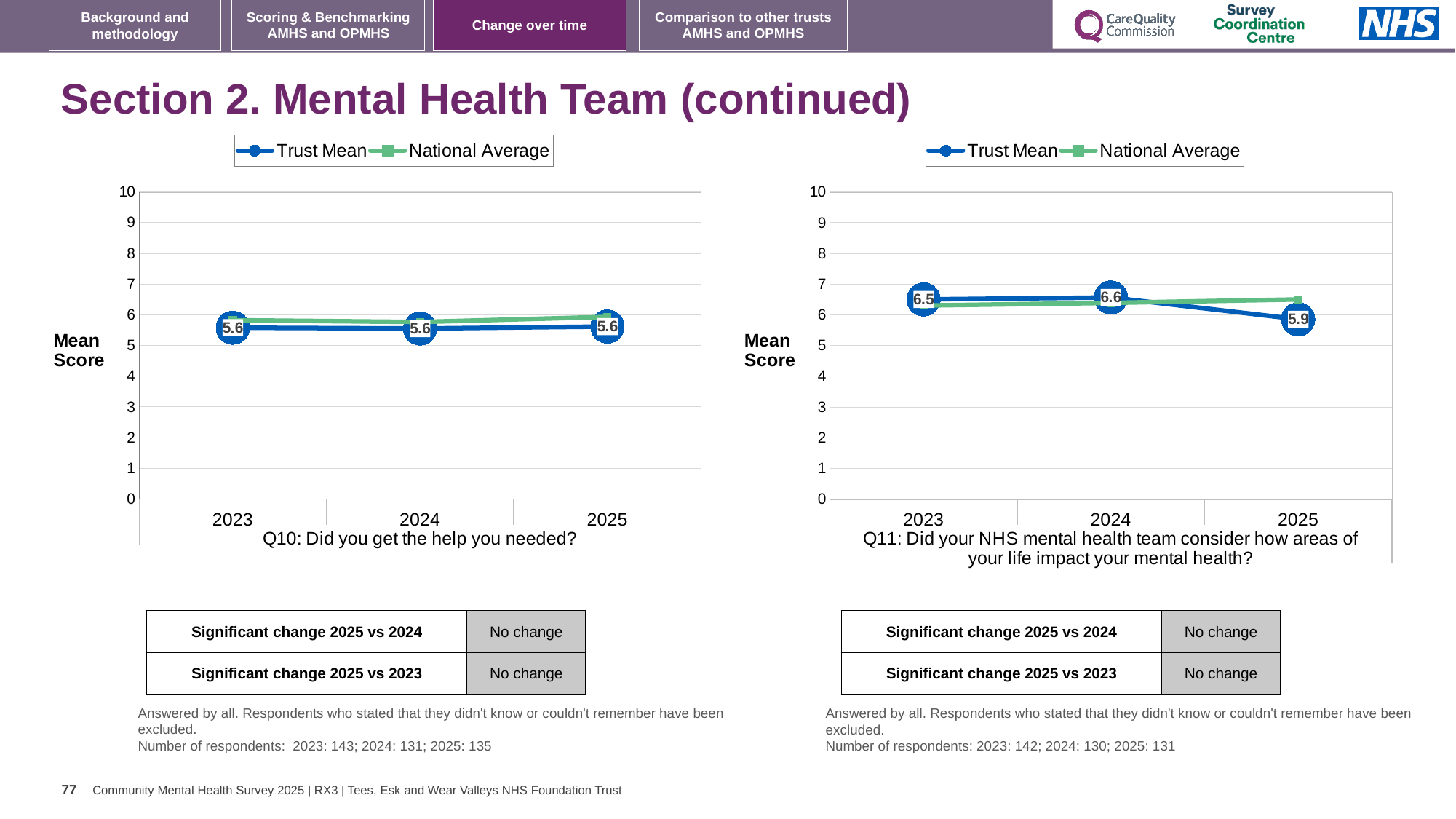
How many years are plotted on the x axis of the Q11 chart? 3 How many series does the legend of the Q10 chart list? 2 In the Q11 chart, which year has the highest Trust Mean score? 2024 In the Q11 chart, what is the Trust Mean score for 2023? 6.5 In the Q10 chart, is the National Average for 2025 greater or less than 5? greater In the Q11 chart, what is the difference between the Trust Mean scores for 2024 and 2025? 0.7 In the Q11 chart, which year has the lowest Trust Mean score? 2025 In the Q10 chart, what is the Trust Mean score for 2025? 5.6 In the Q10 chart, does the Trust Mean rise, fall or stay flat from 2023 to 2025? Stays flat In the Q11 chart, is the Trust Mean score higher in 2024 or in 2025? 2024 What type of chart is used for Q10: Did you get the help you needed? Line chart In the Q11 chart, what is the Trust Mean score for 2025? 5.9